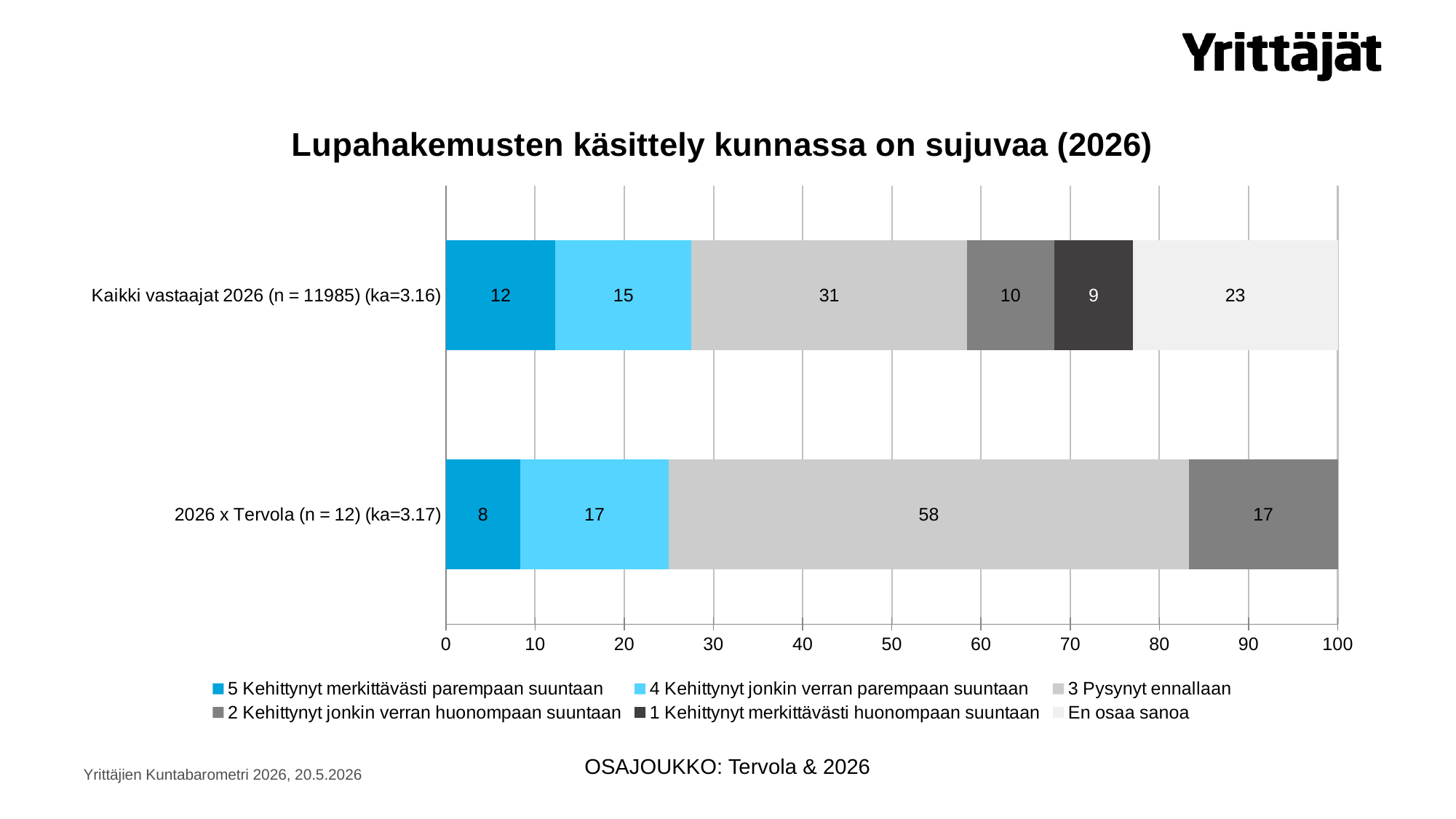
How many series does the legend list? 6 What kind of chart is shown on the slide? Stacked bar chart Which segment is the largest in the "2026 x Tervola (n = 12) (ka=3.17)" bar? 3 Pysynyt ennallaan What is the value of "5 Kehittynyt merkittävästi parempaan suuntaan" for "2026 x Tervola (n = 12) (ka=3.17)"? 8 Which segment is the smallest in the "Kaikki vastaajat 2026 (n = 11985) (ka=3.16)" bar? 1 Kehittynyt merkittävästi huonompaan suuntaan What is the difference between the "3 Pysynyt ennallaan" values for "2026 x Tervola (n = 12) (ka=3.17)" and "Kaikki vastaajat 2026 (n = 11985) (ka=3.16)"? 27 Which has a larger "4 Kehittynyt jonkin verran parempaan suuntaan" value: "Kaikki vastaajat 2026 (n = 11985) (ka=3.16)" or "2026 x Tervola (n = 12) (ka=3.17)"? 2026 x Tervola (n = 12) (ka=3.17) What is the value of "3 Pysynyt ennallaan" for "2026 x Tervola (n = 12) (ka=3.17)"? 58 What is the value of "1 Kehittynyt merkittävästi huonompaan suuntaan" for "Kaikki vastaajat 2026 (n = 11985) (ka=3.16)"? 9 How many categories (bars) are shown on the chart? 2 What is the value of "En osaa sanoa" for "Kaikki vastaajat 2026 (n = 11985) (ka=3.16)"? 23 What is the title of the chart? Lupahakemusten käsittely kunnassa on sujuvaa (2026)